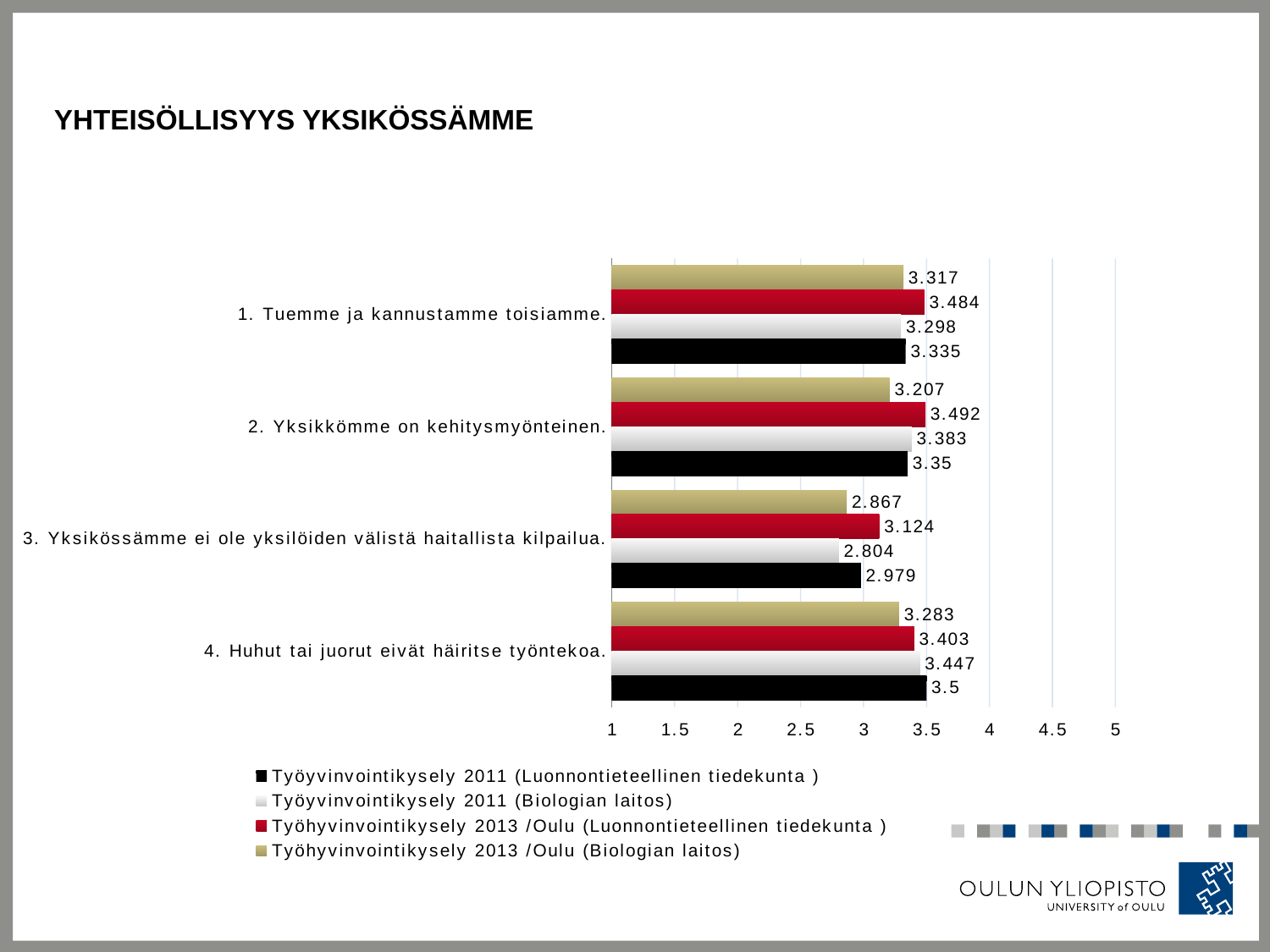
Which category has the lowest value in the Työhyvinvointikysely 2013 /Oulu (Biologian laitos) series? 3. Yksikössämme ei ole yksilöiden välistä haitallista kilpailua. How many series does the legend list? 4 What is the difference between the Työhyvinvointikysely 2013 /Oulu (Luonnontieteellinen tiedekunta) value and the Työyvinvointikysely 2011 (Biologian laitos) value for '3. Yksikössämme ei ole yksilöiden välistä haitallista kilpailua.'? 0.32 What is the value for '2. Yksikkömme on kehitysmyönteinen.' in the Työhyvinvointikysely 2013 /Oulu (Biologian laitos) series? 3.207 For '4. Huhut tai juorut eivät häiritse työntekoa.', which is larger: the Työyvinvointikysely 2011 (Biologian laitos) value or the Työhyvinvointikysely 2013 /Oulu (Biologian laitos) value? Työyvinvointikysely 2011 (Biologian laitos) How many categories (statements) are plotted on the chart? 4 What is the value for '4. Huhut tai juorut eivät häiritse työntekoa.' in the Työyvinvointikysely 2011 (Luonnontieteellinen tiedekunta) series? 3.5 What is the value for '1. Tuemme ja kannustamme toisiamme.' in the Työhyvinvointikysely 2013 /Oulu (Luonnontieteellinen tiedekunta) series? 3.484 Which category has the highest value in the Työhyvinvointikysely 2013 /Oulu (Luonnontieteellinen tiedekunta) series? 2. Yksikkömme on kehitysmyönteinen. What kind of chart is shown on the slide? bar chart What is the title of the slide containing the chart? YHTEISÖLLISYYS YKSIKÖSSÄMME What is the value for '3. Yksikössämme ei ole yksilöiden välistä haitallista kilpailua.' in the Työyvinvointikysely 2011 (Biologian laitos) series? 2.804